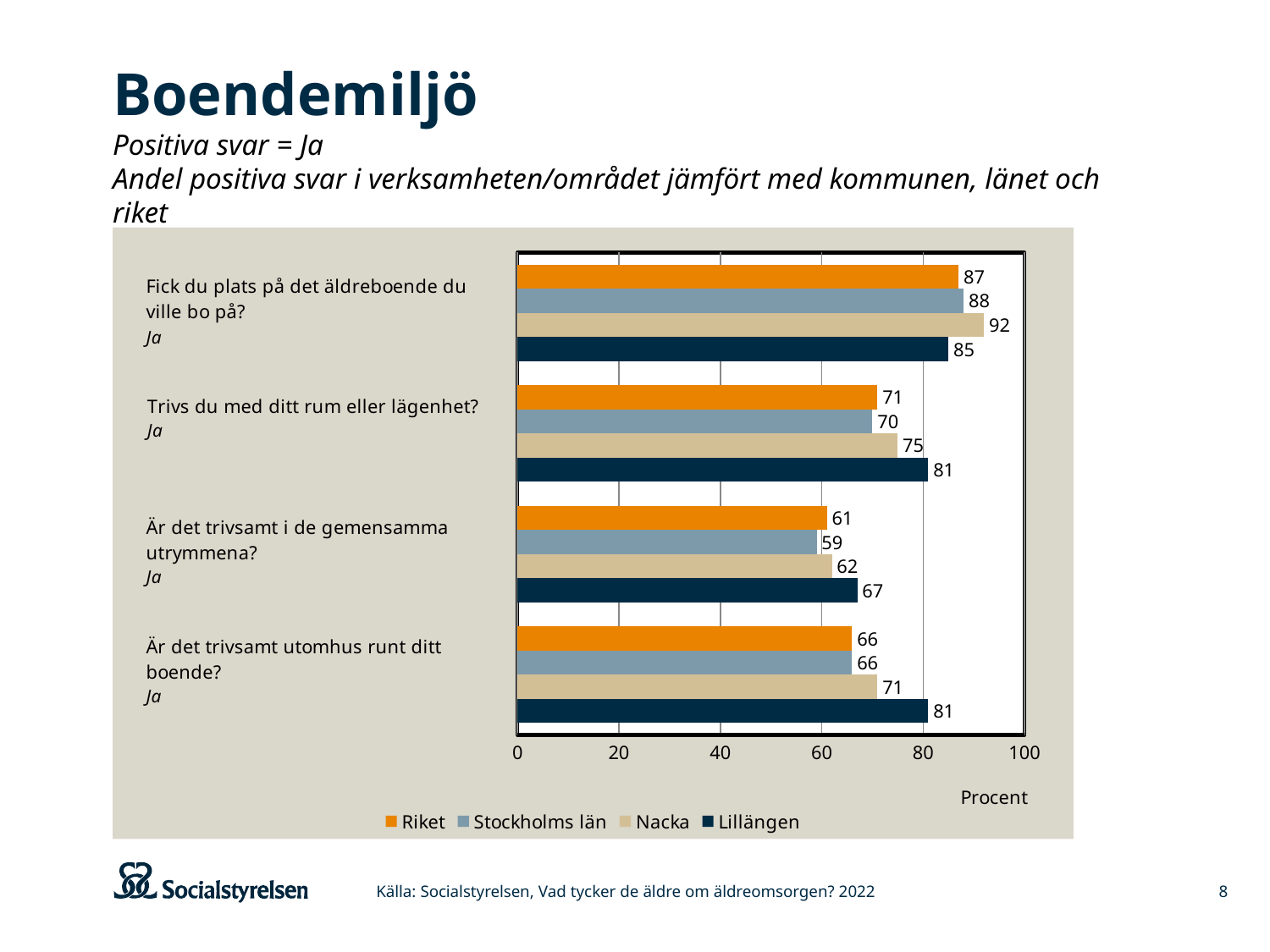
Which series has the highest value for the question "Fick du plats på det äldreboende du ville bo på?" Nacka What is the label on the horizontal axis of the chart? Procent What value is shown for Lillängen on the question "Trivs du med ditt rum eller lägenhet?" 81 What value is shown for Riket on the question "Är det trivsamt utomhus runt ditt boende?" 66 Which series has the lowest value for the question "Är det trivsamt i de gemensamma utrymmena?" Stockholms län What value is shown for Nacka on the question "Fick du plats på det äldreboende du ville bo på?" 92 How many questions (categories) are shown on the chart? 4 What value is shown for Stockholms län on the question "Är det trivsamt i de gemensamma utrymmena?" 59 What is the difference between the Lillängen and Riket values for "Är det trivsamt utomhus runt ditt boende?" 15 What kind of chart is shown on the slide? Bar chart For "Trivs du med ditt rum eller lägenhet?", which is larger: the value for Nacka or the value for Riket? Nacka How many series does the legend list? 4